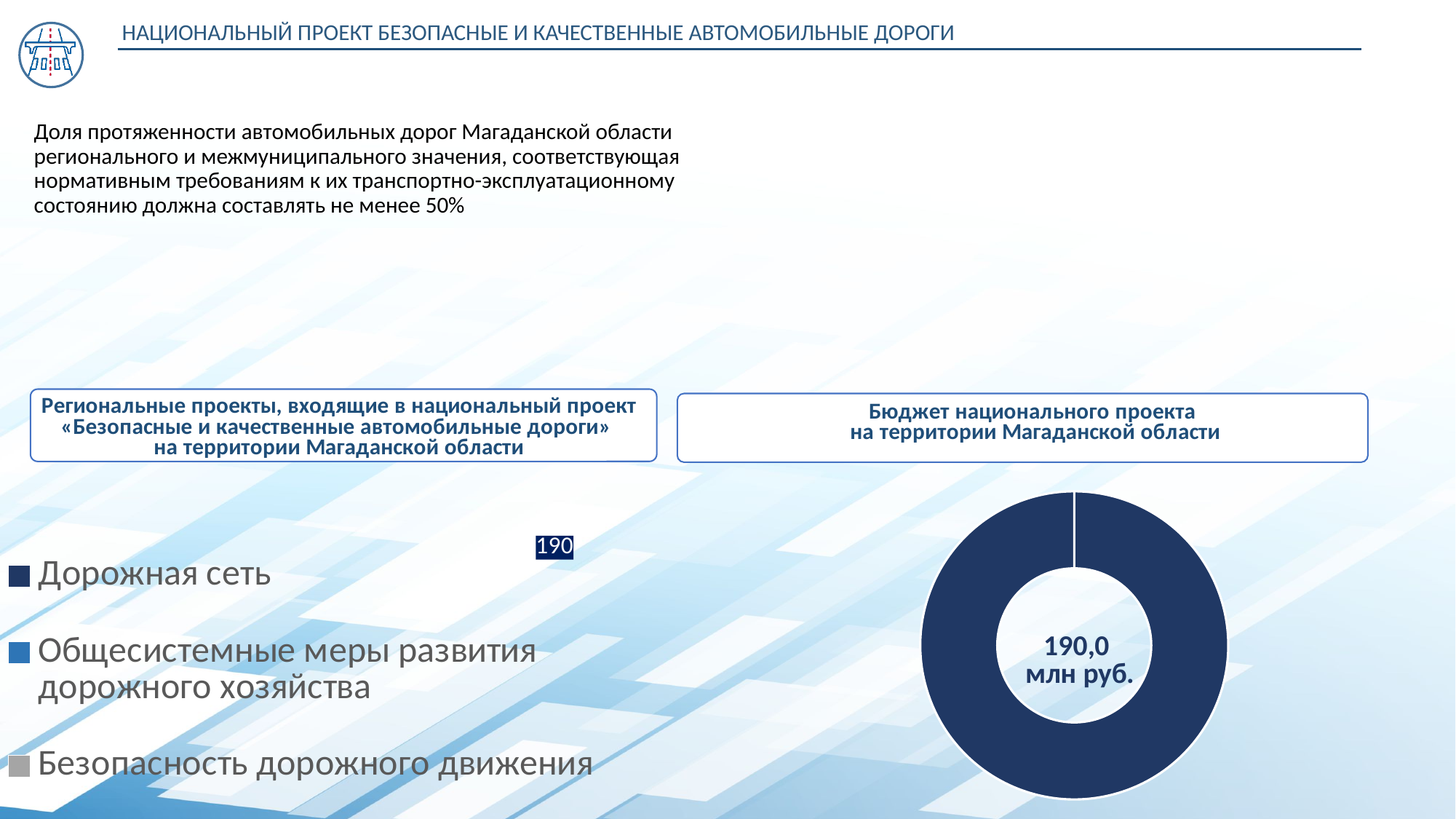
What text is shown in the centre of the doughnut chart? 190,0 млн руб. What value is printed as the data label on the doughnut chart? 190 Which legend category fills the entire ring of the doughnut chart? Дорожная сеть Which legend entry of the doughnut chart is shown in grey? Безопасность дорожного движения What kind of chart is shown under the heading «Бюджет национального проекта на территории Магаданской области»? Doughnut (pie) chart Is the value labelled on the doughnut chart greater or less than 100? greater What is the value for «Дорожная сеть» in the doughnut chart? 190 How many entries does the legend of the doughnut chart list? 3 Which legend entry of the doughnut chart is shown in dark blue? Дорожная сеть